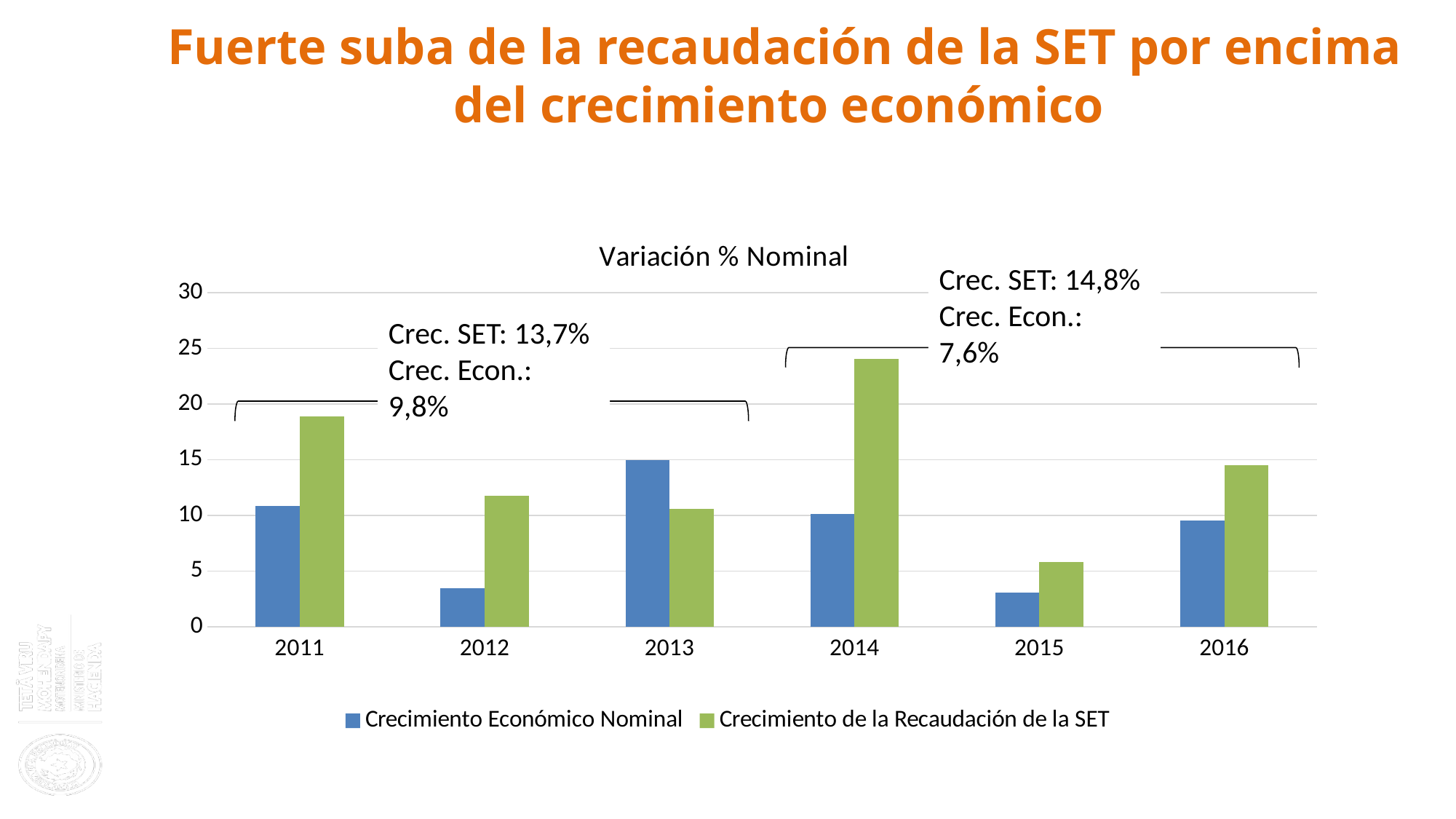
Is the value for Crecimiento de la Recaudación de la SET in 2014 greater or less than 20? greater What is the title of the chart? Variación % Nominal In which year is the value for Crecimiento de la Recaudación de la SET highest? 2014 In 2014, which is larger: Crecimiento Económico Nominal or Crecimiento de la Recaudación de la SET? Crecimiento de la Recaudación de la SET What kind of chart is shown on the slide? bar chart How many years are shown on the x axis? 6 Is the value for Crecimiento de la Recaudación de la SET in 2011 greater or less than 20? less In which year is the value for Crecimiento Económico Nominal highest? 2013 Is the value for Crecimiento Económico Nominal in 2012 greater or less than 5? less How many series does the legend list? 2 In which year is the value for Crecimiento de la Recaudación de la SET lowest? 2015 In 2013, which is larger: Crecimiento Económico Nominal or Crecimiento de la Recaudación de la SET? Crecimiento Económico Nominal